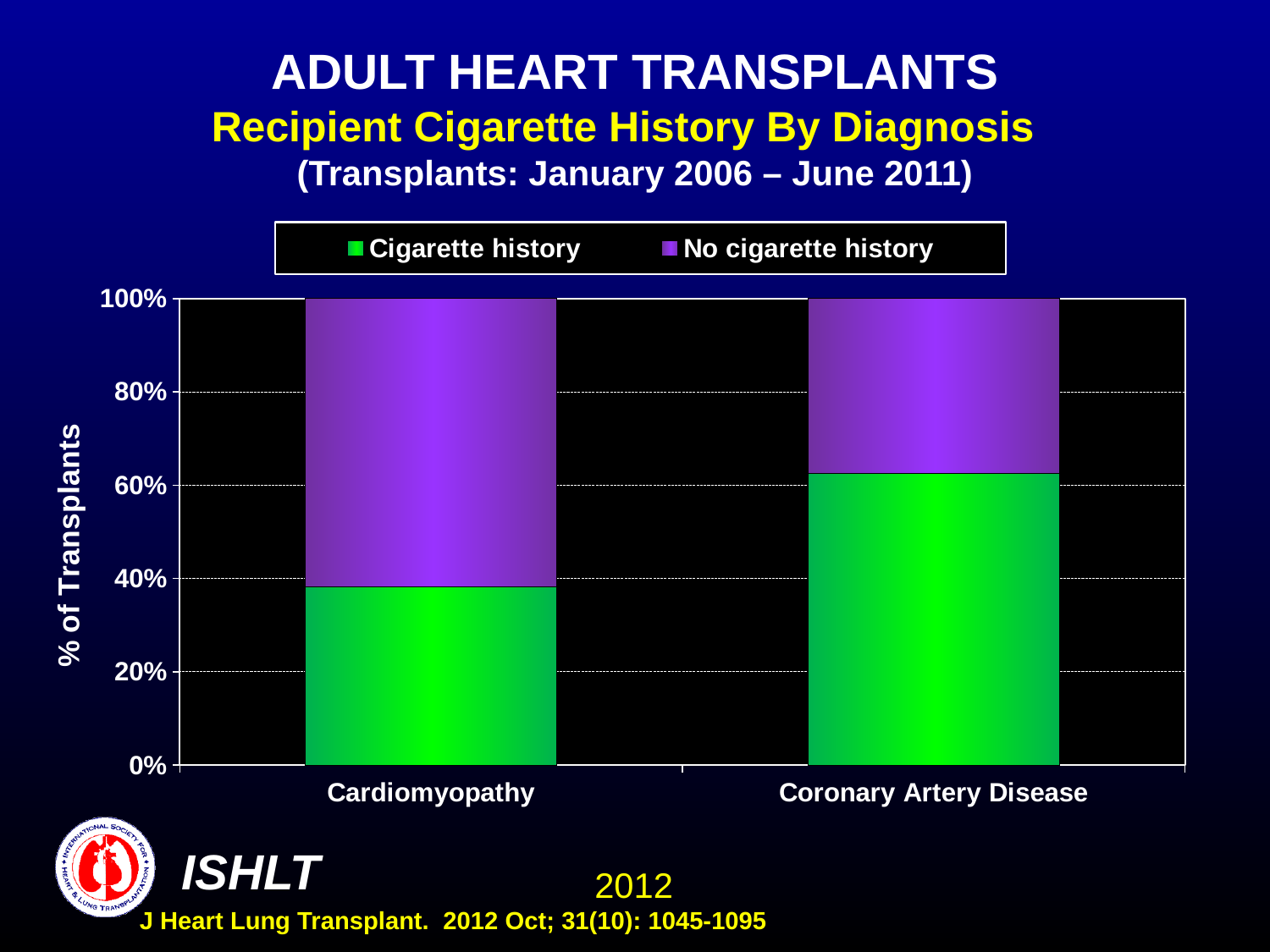
Which diagnosis has the higher share of recipients with a cigarette history? Coronary Artery Disease How many diagnosis categories are shown on the x axis? 2 Which colour represents 'No cigarette history' in the legend? Purple Which diagnosis has the lower share of recipients with a cigarette history? Cardiomyopathy Is the cigarette history share for Cardiomyopathy greater or less than 40%? less What is the total height of the stacked bar for Cardiomyopathy? 100% Is the cigarette history share for Cardiomyopathy greater or less than 20%? greater Which is larger for Cardiomyopathy: the cigarette history segment or the no cigarette history segment? No cigarette history Which is larger for Coronary Artery Disease: the cigarette history segment or the no cigarette history segment? Cigarette history What kind of chart is shown on the slide? Stacked bar chart How many series does the legend list? 2 Is the cigarette history share for Coronary Artery Disease greater or less than 60%? greater